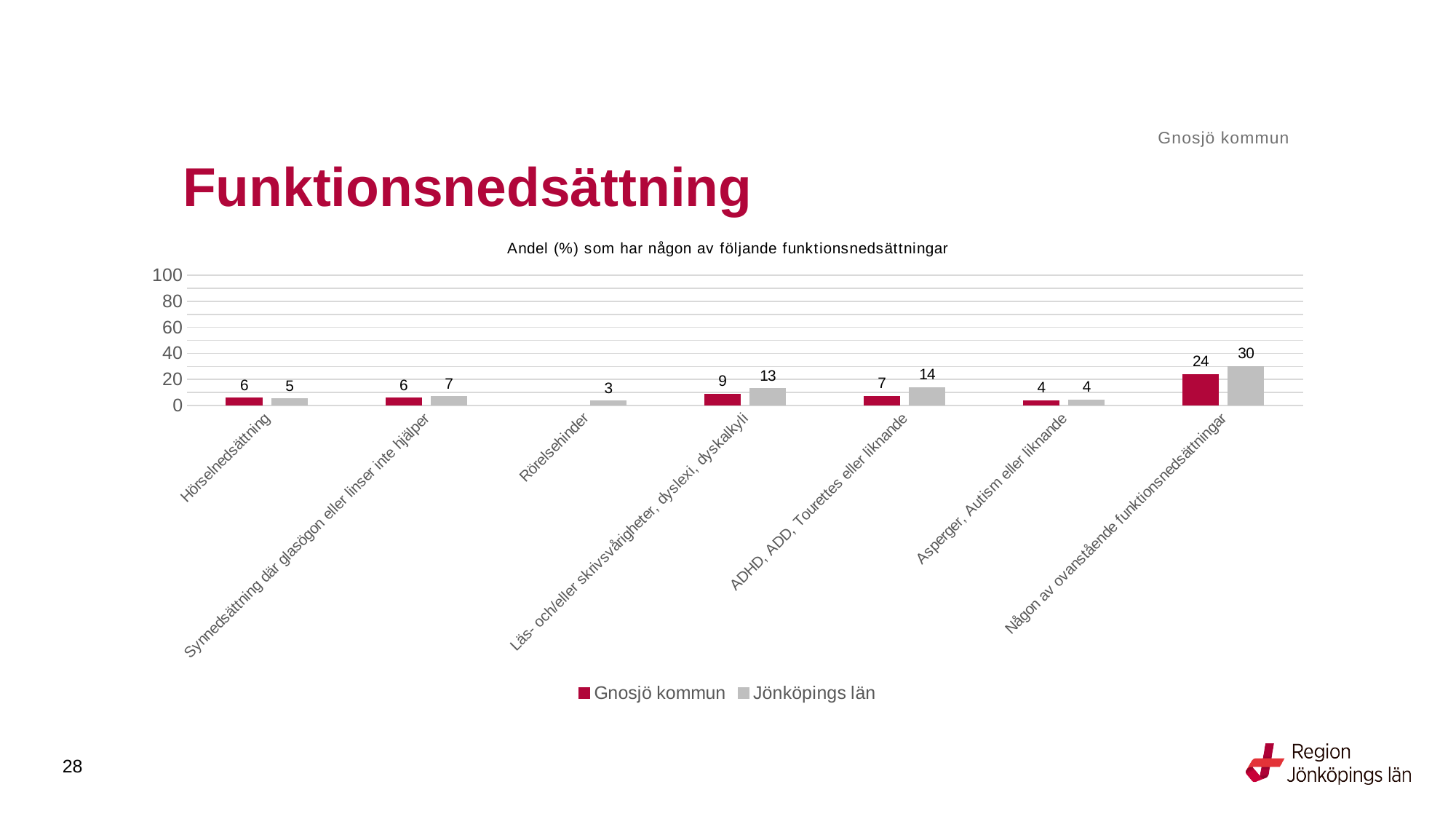
What kind of chart is shown on the slide? Bar chart What is the difference between Jönköpings län and Gnosjö kommun for ADHD, ADD, Tourettes eller liknande? 7 What is the difference between Jönköpings län and Gnosjö kommun for Någon av ovanstående funktionsnedsättningar? 6 What is the value for Jönköpings län for ADHD, ADD, Tourettes eller liknande? 14 How many series does the legend list? 2 What is the value for Jönköpings län for Rörelsehinder? 3 How many categories are shown on the x axis? 7 Which category has the highest value for Jönköpings län? Någon av ovanstående funktionsnedsättningar What is the value for Gnosjö kommun for Hörselnedsättning? 6 For Läs- och/eller skrivsvårigheter, dyslexi, dyskalkyli, which is larger: Gnosjö kommun or Jönköpings län? Jönköpings län What is the value for Gnosjö kommun for Någon av ovanstående funktionsnedsättningar? 24 Which category has the lowest value for Gnosjö kommun among those with a labelled Gnosjö kommun bar? Asperger, Autism eller liknande